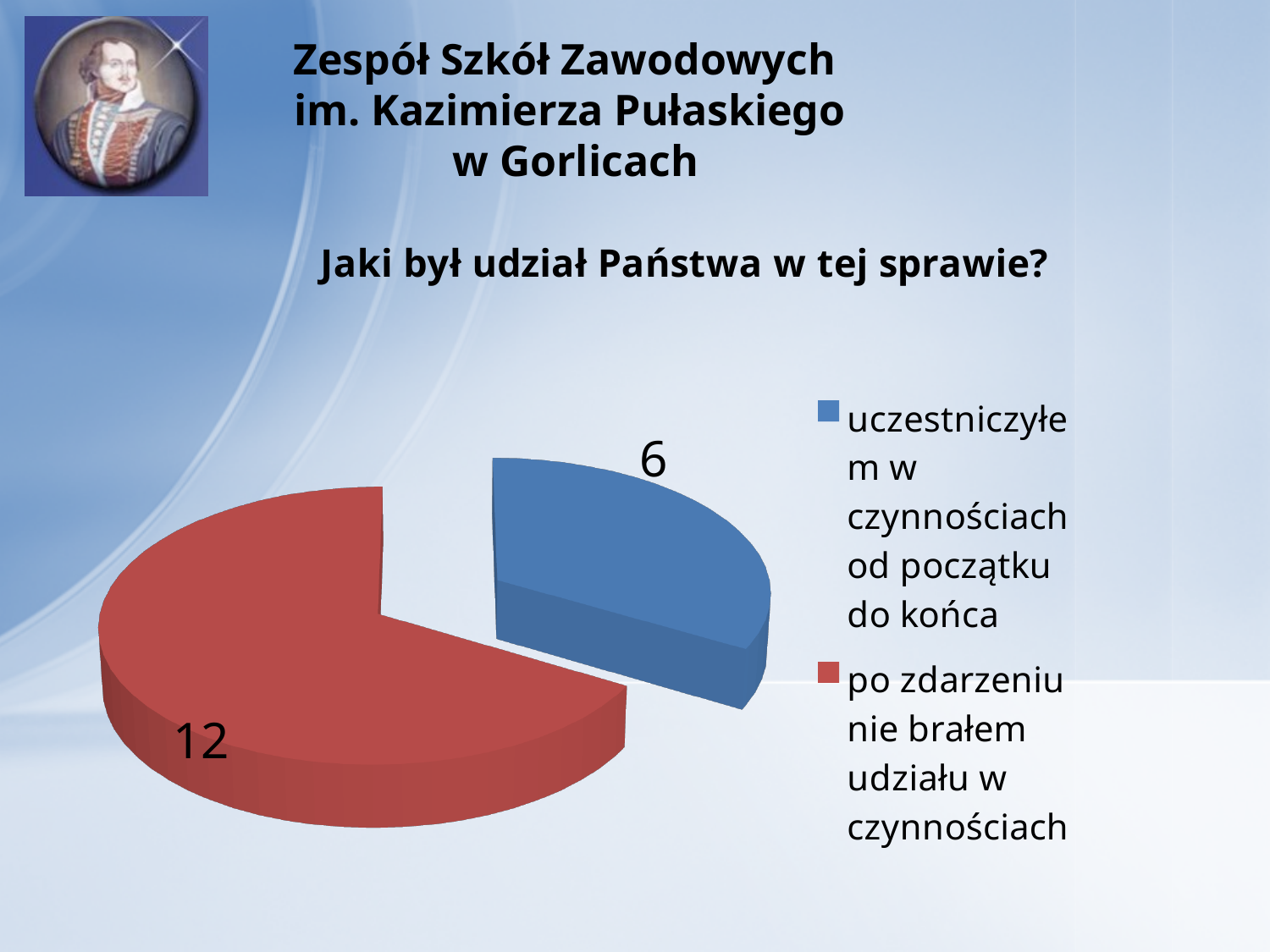
How many slices does the pie chart have? 2 What is the total of all slices in the pie chart? 18 Which category has the largest slice of the pie? po zdarzeniu nie brałem udziału w czynnościach What share of the pie does "po zdarzeniu nie brałem udziału w czynnościach" represent? two thirds Which category has the smallest slice of the pie? uczestniczyłem w czynnościach od początku do końca What colour is the slice for "uczestniczyłem w czynnościach od początku do końca"? blue Which is larger: the value for "uczestniczyłem w czynnościach od początku do końca" or the value for "po zdarzeniu nie brałem udziału w czynnościach"? po zdarzeniu nie brałem udziału w czynnościach What is the difference between the value for "po zdarzeniu nie brałem udziału w czynnościach" and the value for "uczestniczyłem w czynnościach od początku do końca"? 6 What is the value for "uczestniczyłem w czynnościach od początku do końca"? 6 What type of chart is shown on the slide? pie chart What is the value for "po zdarzeniu nie brałem udziału w czynnościach"? 12 What is the title of the chart? Jaki był udział Państwa w tej sprawie?